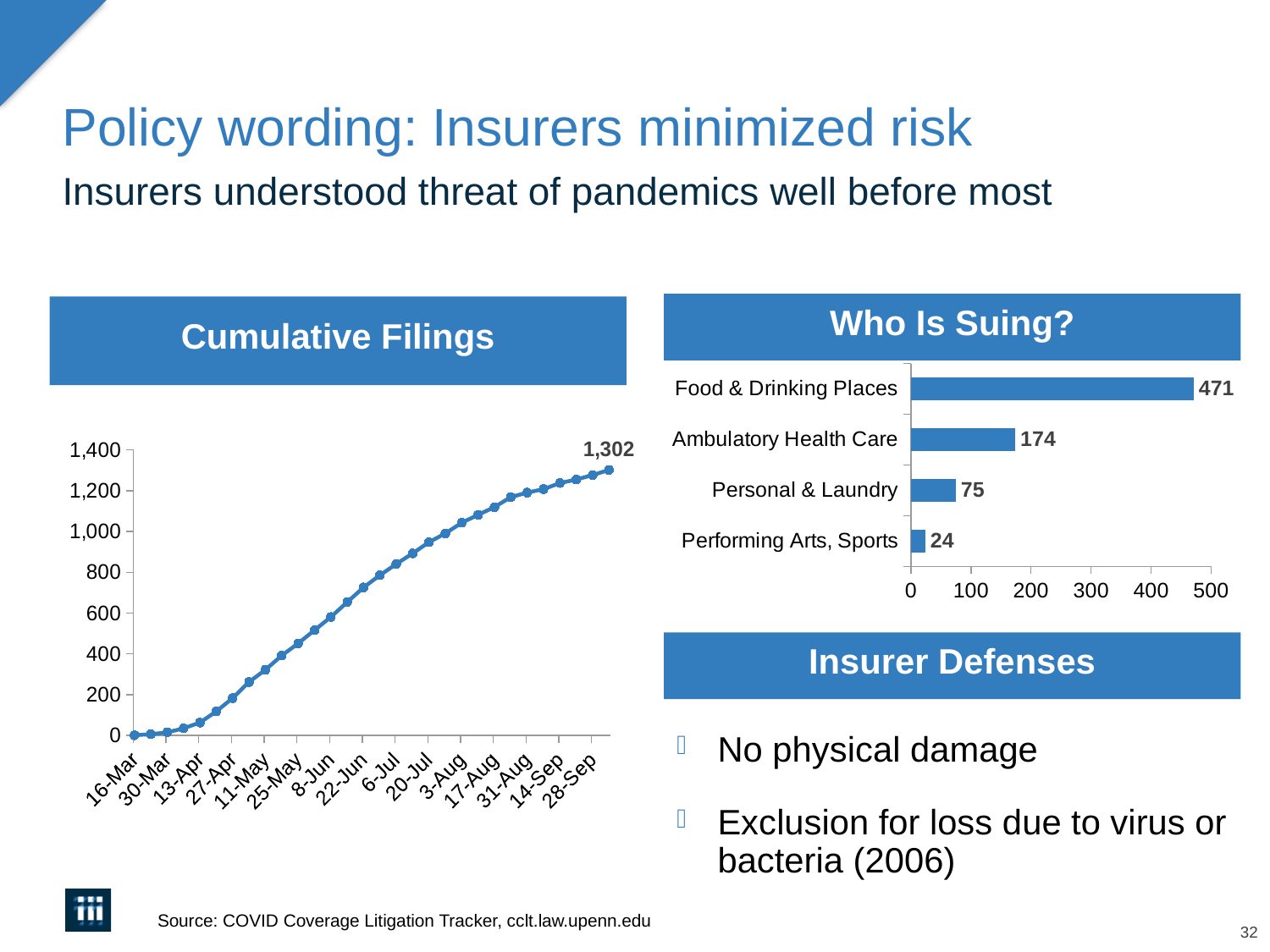
What kind of chart is the Who Is Suing? chart? bar chart On the Who Is Suing? chart, how many categories are shown? 4 On the Cumulative Filings chart, what is the final labeled value at 28-Sep? 1,302 On the Who Is Suing? chart, what is the difference between Food & Drinking Places and Ambulatory Health Care? 297 On the Cumulative Filings chart, is the value for 20-Jul greater or less than 800? greater What kind of chart is the Cumulative Filings chart? line chart On the Who Is Suing? chart, what is the value for Ambulatory Health Care? 174 On the Who Is Suing? chart, what is the value for Performing Arts, Sports? 24 On the Who Is Suing? chart, which category has the highest value? Food & Drinking Places On the Cumulative Filings chart, is the value for 16-Mar greater or less than 200? less On the Cumulative Filings chart, do the values rise or fall from 16-Mar to 28-Sep? rise On the Who Is Suing? chart, which category has the lowest value? Performing Arts, Sports